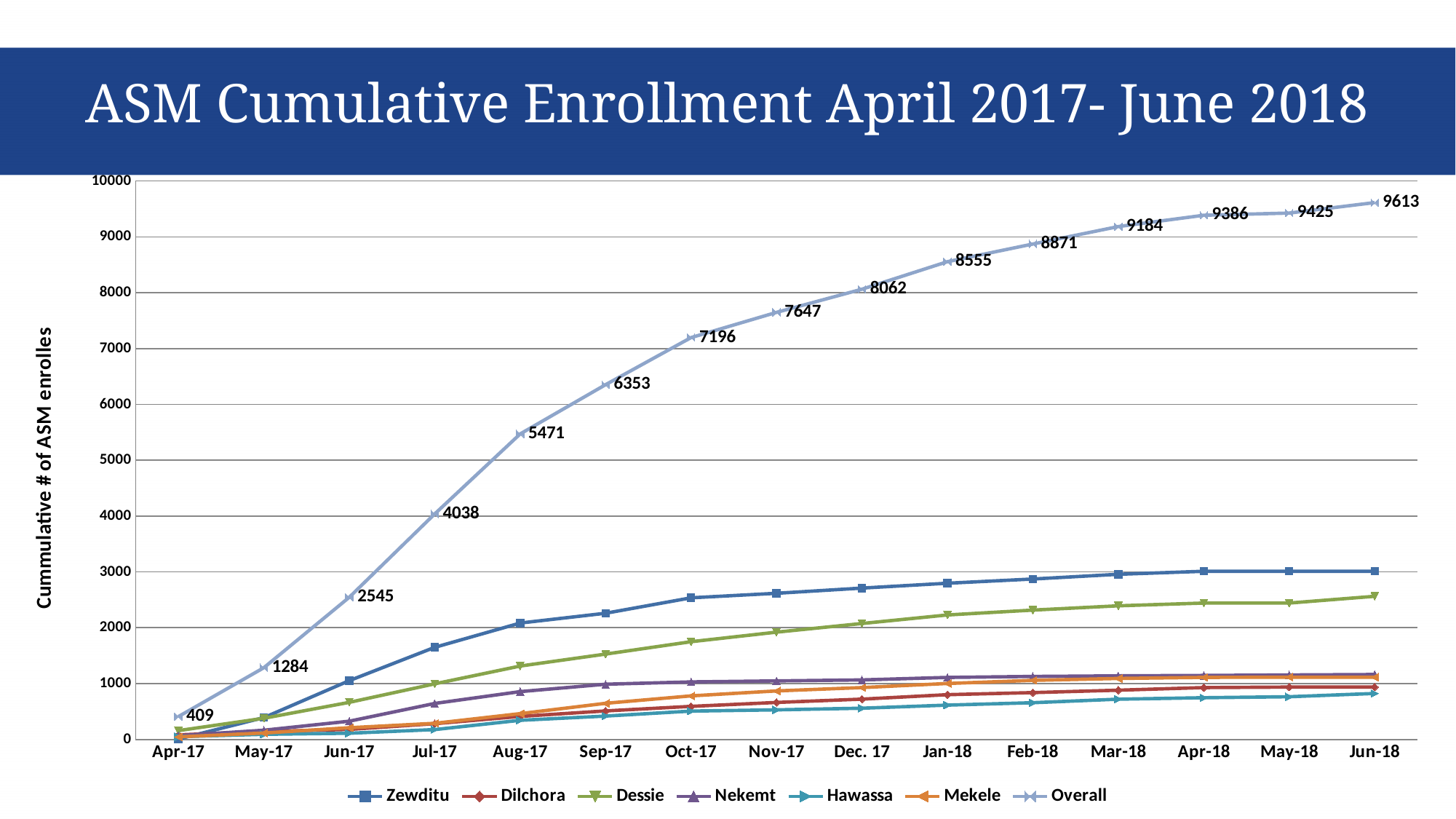
How many series does the legend list? 7 Is the Zewditu value for Jun-18 greater or less than 2000? greater How many months are shown on the x axis? 15 Which site series has the highest cumulative enrollment in Jun-18? Zewditu By how much did the Overall cumulative enrollment increase from Jul-17 to Aug-17? 1433 What is the Overall cumulative enrollment in Oct-17? 7196 What is the Overall cumulative enrollment in Apr-17? 409 What kind of chart is shown on the slide? Line chart Which site series has the lowest cumulative enrollment in Jun-18? Hawassa Does the Overall cumulative enrollment rise or fall from Apr-17 to Jun-18? Rise What is the difference between the Overall values for Jun-18 and May-18? 188 What is the Overall cumulative enrollment in Jun-18? 9613